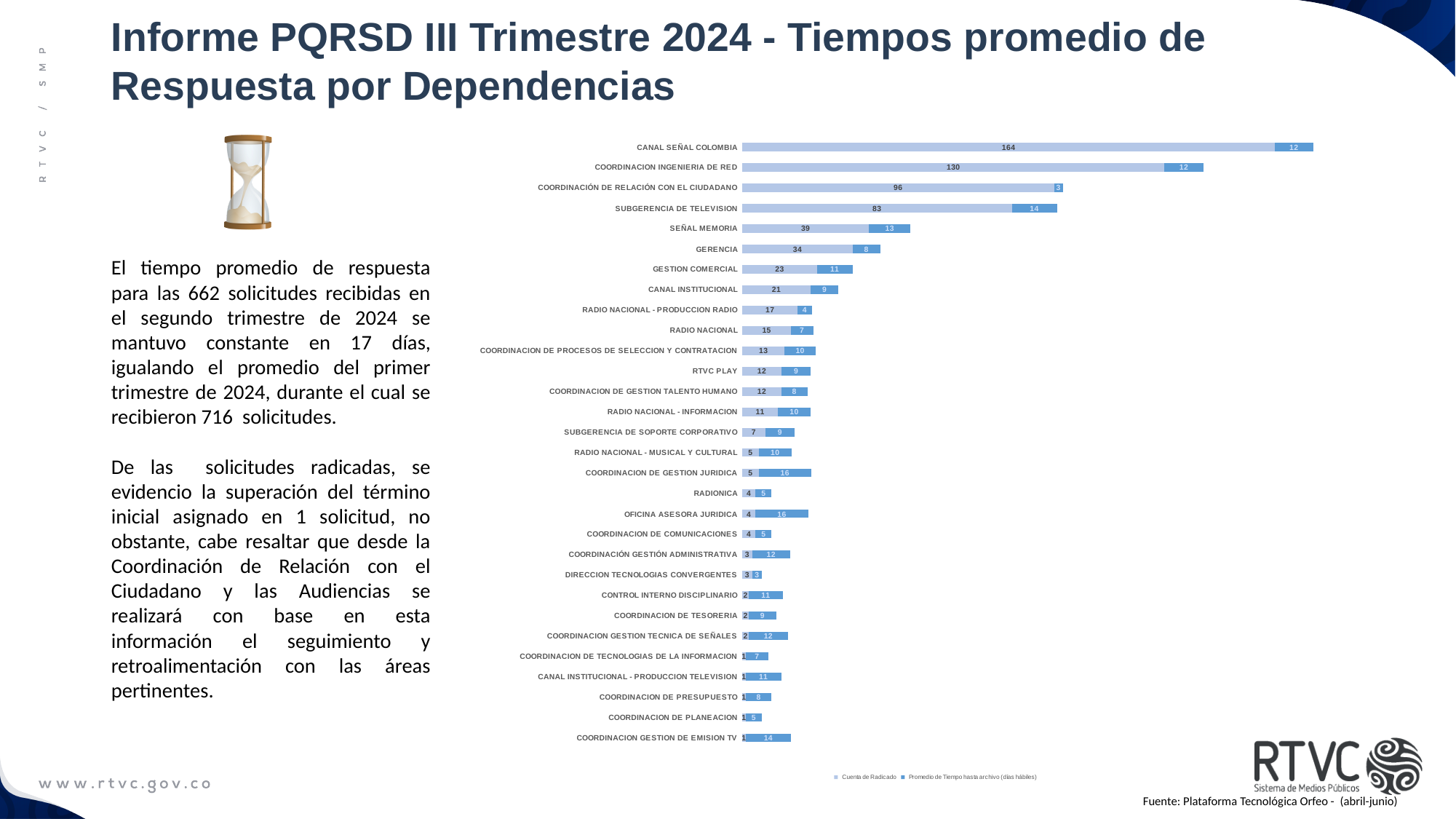
What is the total of the stacked bar for COORDINACIÓN DE RELACIÓN CON EL CIUDADANO? 99 What is the Cuenta de Radicado value for CANAL SEÑAL COLOMBIA? 164 How many series does the chart legend list? 2 What is the difference in Cuenta de Radicado between CANAL SEÑAL COLOMBIA and COORDINACION INGENIERIA DE RED? 34 What is the Cuenta de Radicado value for RTVC PLAY? 12 Which dependency has the highest Cuenta de Radicado? CANAL SEÑAL COLOMBIA What is the Promedio de Tiempo hasta archivo value for COORDINACION DE GESTION JURIDICA? 16 What type of chart is shown on the slide? Bar chart How many dependencies (categories) are plotted in the chart? 30 Which has a larger Cuenta de Radicado, SEÑAL MEMORIA or GERENCIA? SEÑAL MEMORIA Which series is shown in the lighter blue colour in the chart? Cuenta de Radicado What is the Promedio de Tiempo hasta archivo value for SUBGERENCIA DE TELEVISION? 14